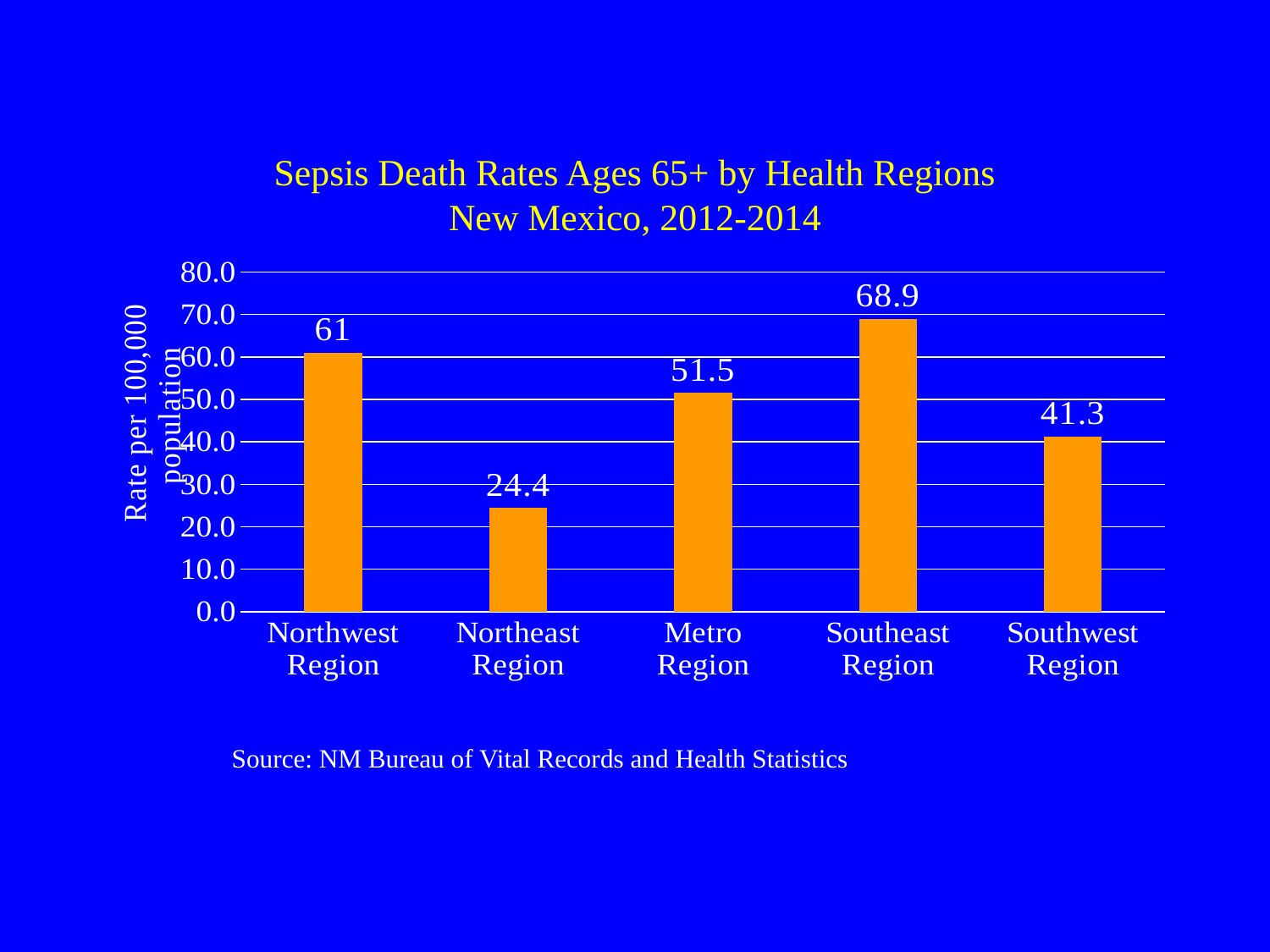
Which region has the lowest sepsis death rate? Northeast Region What is the sepsis death rate for the Southwest Region? 41.3 What is the label of the vertical axis? Rate per 100,000 population What is the sepsis death rate for the Northwest Region? 61 How many health regions are shown in the chart? 5 What is the sepsis death rate for the Metro Region? 51.5 Which has a higher sepsis death rate, the Metro Region or the Southwest Region? Metro Region What is the sepsis death rate for the Northeast Region? 24.4 Which region has the highest sepsis death rate? Southeast Region What kind of chart is shown on the slide? Bar chart Is the value for the Southeast Region greater or less than 60.0? greater What is the difference between the sepsis death rates of the Southeast Region and the Northeast Region? 44.5